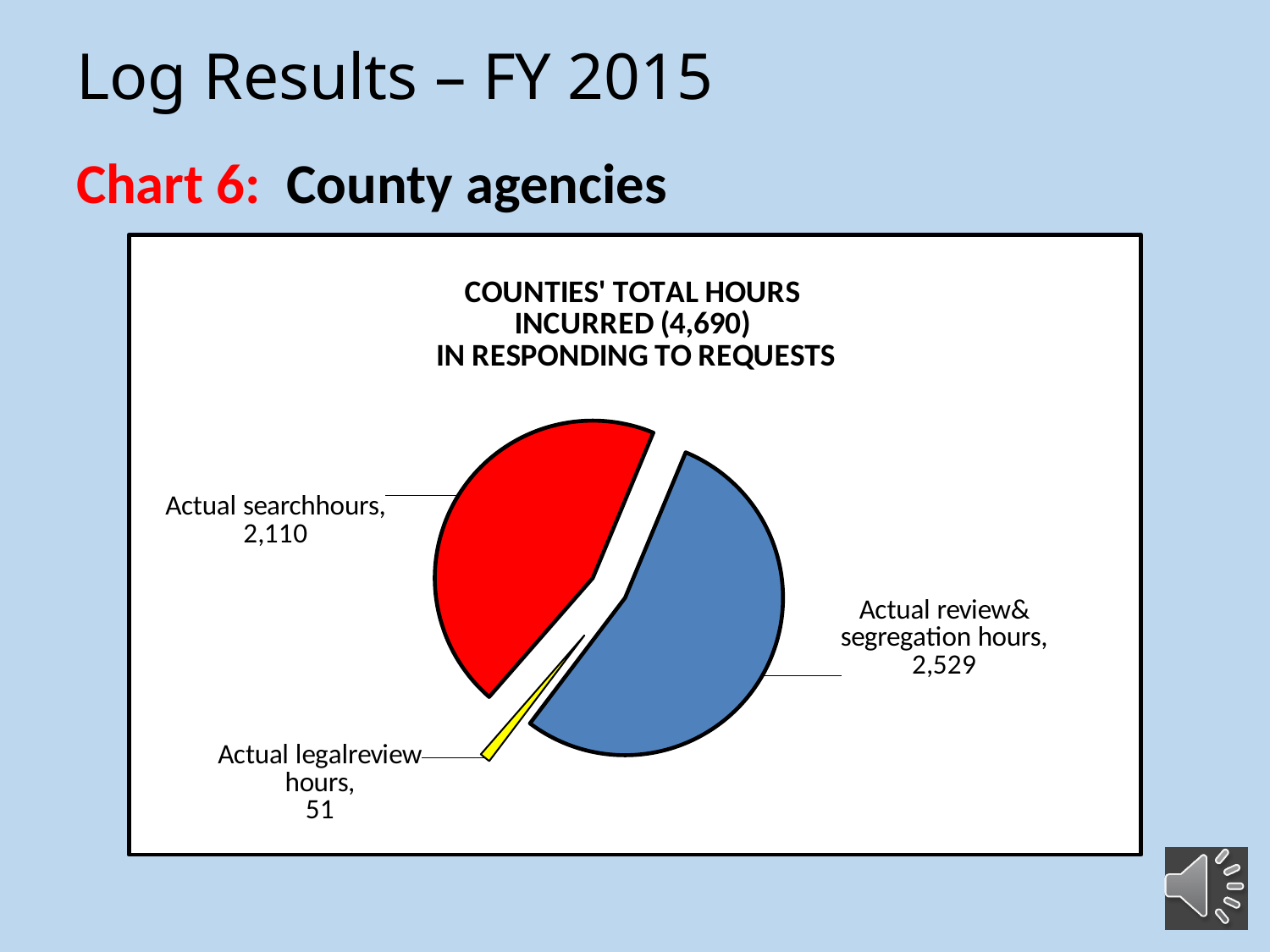
What type of chart is shown on the slide? Pie chart Which category has the smallest slice of the pie? Actual legal review hours How many hours are shown for Actual legal review hours? 51 How many categories are shown in the pie chart? 3 How many hours are shown for Actual search hours? 2,110 How many hours are shown for Actual review & segregation hours? 2,529 Which is larger, Actual search hours or Actual review & segregation hours? Actual review & segregation hours What colour is the slice for Actual search hours? Red What is the difference between Actual search hours and Actual legal review hours? 2,059 What is the total number of hours incurred according to the chart title? 4,690 What is the difference between Actual review & segregation hours and Actual search hours? 419 Which category has the largest slice of the pie? Actual review & segregation hours